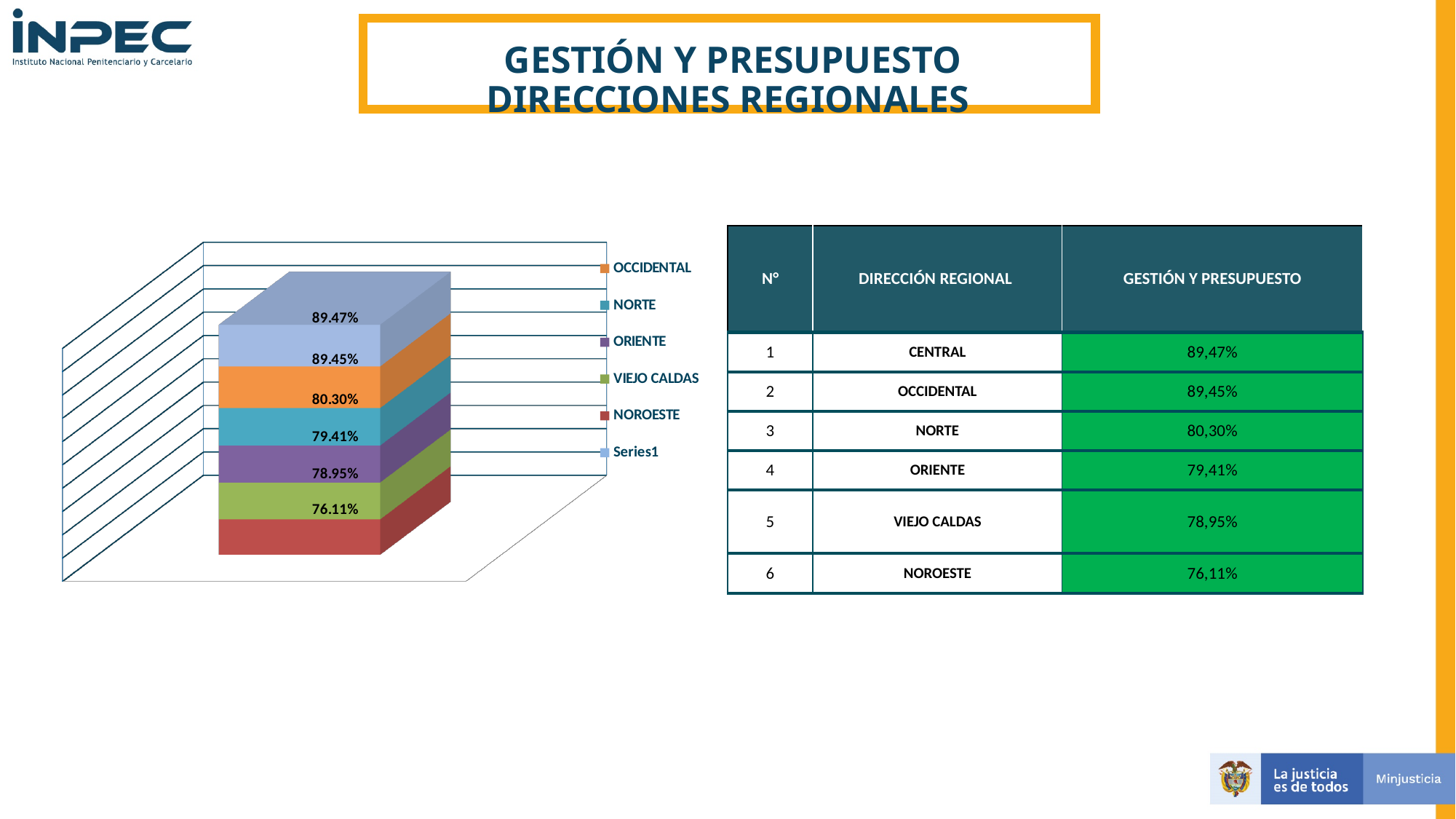
What value is labelled for OCCIDENTAL in the chart? 89.45% How many segments make up the stacked bar in the chart? 6 What is the lowest value labelled on the chart? 76.11% What value is labelled for ORIENTE in the chart? 79.41% What value is labelled for NORTE in the chart? 80.30% Which legend entry in the chart is shown with a red marker? NOROESTE What value is labelled for VIEJO CALDAS in the chart? 78.95% What is the difference between the highest labelled value (89.47%) and the lowest labelled value (76.11%) in the chart? 13.36% Which is larger in the chart, the value for NORTE or the value for ORIENTE? NORTE How many entries does the chart's legend list? 6 What is the highest value labelled on the chart? 89.47% What kind of chart is shown on the left of the slide? bar chart